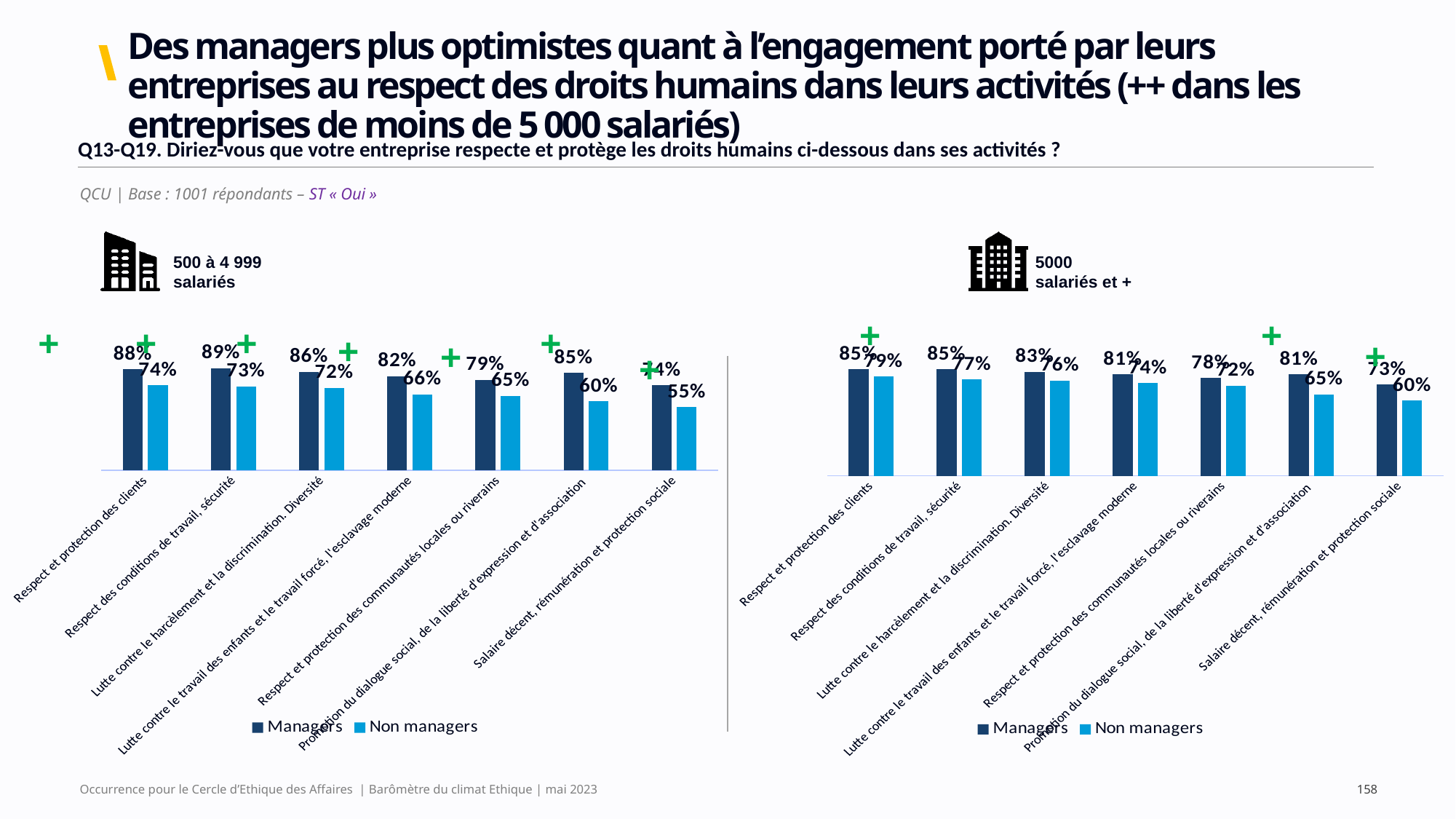
In the chart for 500 à 4 999 salariés, what is the difference between Managers and Non managers for 'Promotion du dialogue social, de la liberté d'expression et d'association'? 25 points In the chart for 500 à 4 999 salariés, which category has the highest Managers value? Respect des conditions de travail, sécurité What type of chart is used for 500 à 4 999 salariés? Bar chart In the chart for 500 à 4 999 salariés, which category has the lowest Non managers value? Salaire décent, rémunération et protection sociale How many categories are shown in the chart for 5000 salariés et +? 7 In the chart for 5000 salariés et +, what is the difference between Managers and Non managers for 'Promotion du dialogue social, de la liberté d'expression et d'association'? 16 points In the chart for 5000 salariés et +, what is the value for Non managers for 'Respect et protection des clients'? 79% In the chart for 500 à 4 999 salariés, what is the value for Non managers for 'Salaire décent, rémunération et protection sociale'? 55% In the chart for 5000 salariés et +, what is the value for Managers for 'Respect et protection des communautés locales ou riverains'? 78% In the chart for 5000 salariés et +, which is larger: the Non managers value for 'Lutte contre le harcèlement et la discrimination. Diversité' or for 'Salaire décent, rémunération et protection sociale'? Lutte contre le harcèlement et la discrimination. Diversité In the chart for 500 à 4 999 salariés, what is the value for Managers for 'Respect des conditions de travail, sécurité'? 89% How many series does the legend list in the chart for 500 à 4 999 salariés? 2